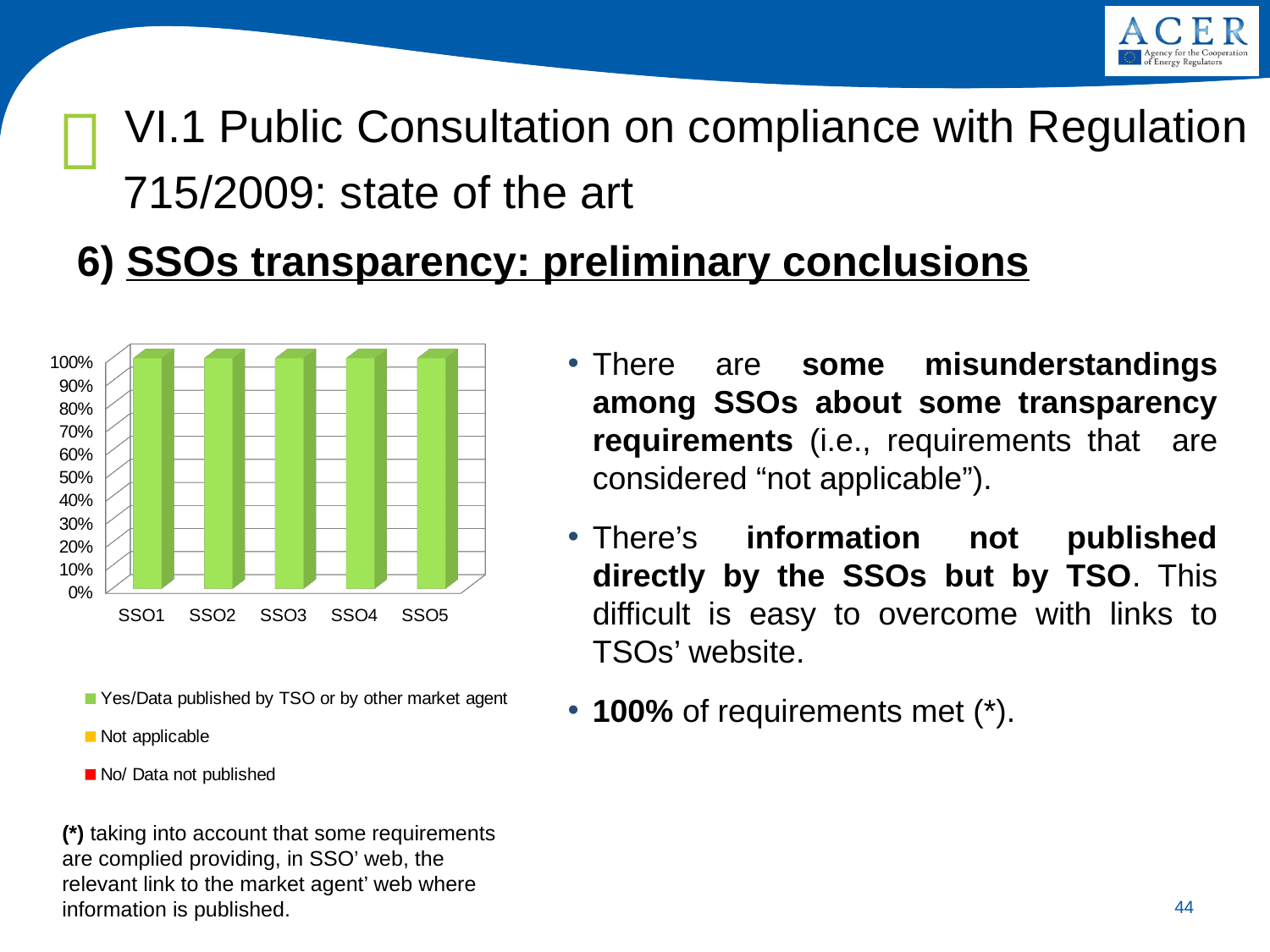
What is the value for SSO3 in the 'Yes/Data published by TSO or by other market agent' series? 100% What kind of chart is shown on the slide? bar chart What is the label of the first category on the x axis? SSO1 What is the difference between the values for SSO1 and SSO5? 0% Do the values rise, fall or stay the same from SSO1 to SSO5? stay the same What is the value for SSO5 in the 'Yes/Data published by TSO or by other market agent' series? 100% How many series does the chart's legend list? 3 How many categories are shown on the x axis of the chart? 5 Is the value for SSO4 greater or less than 90%? greater Is the value for SSO2 greater or less than 50%? greater What is the value for SSO1 in the 'Yes/Data published by TSO or by other market agent' series? 100% Which legend entry is shown in green? Yes/Data published by TSO or by other market agent